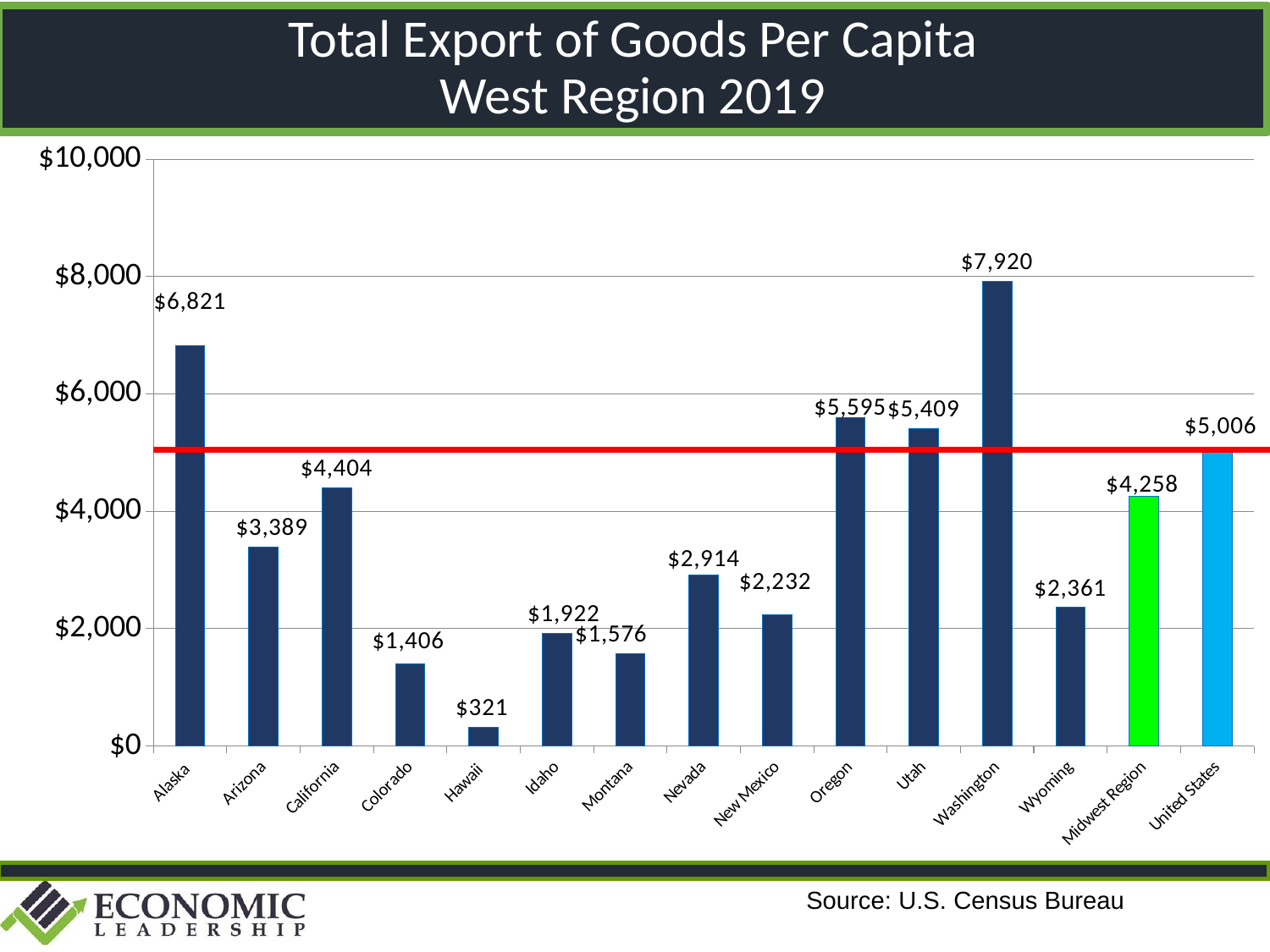
How many categories are shown on the x axis? 15 What is the total export of goods per capita for Washington? $7,920 Which category has the lowest total export of goods per capita? Hawaii What is the title of the chart? Total Export of Goods Per Capita West Region 2019 Which is larger, the value for Oregon or the value for Utah? Oregon What kind of chart is shown on the slide? Bar chart Is the value for California greater or less than $4,000? greater What is the difference between the United States value and the Midwest Region value? $748 What is the value shown for the Midwest Region? $4,258 Which category has the highest total export of goods per capita? Washington What is the value shown for Hawaii? $321 What is the difference between the values for Washington and Alaska? $1,099